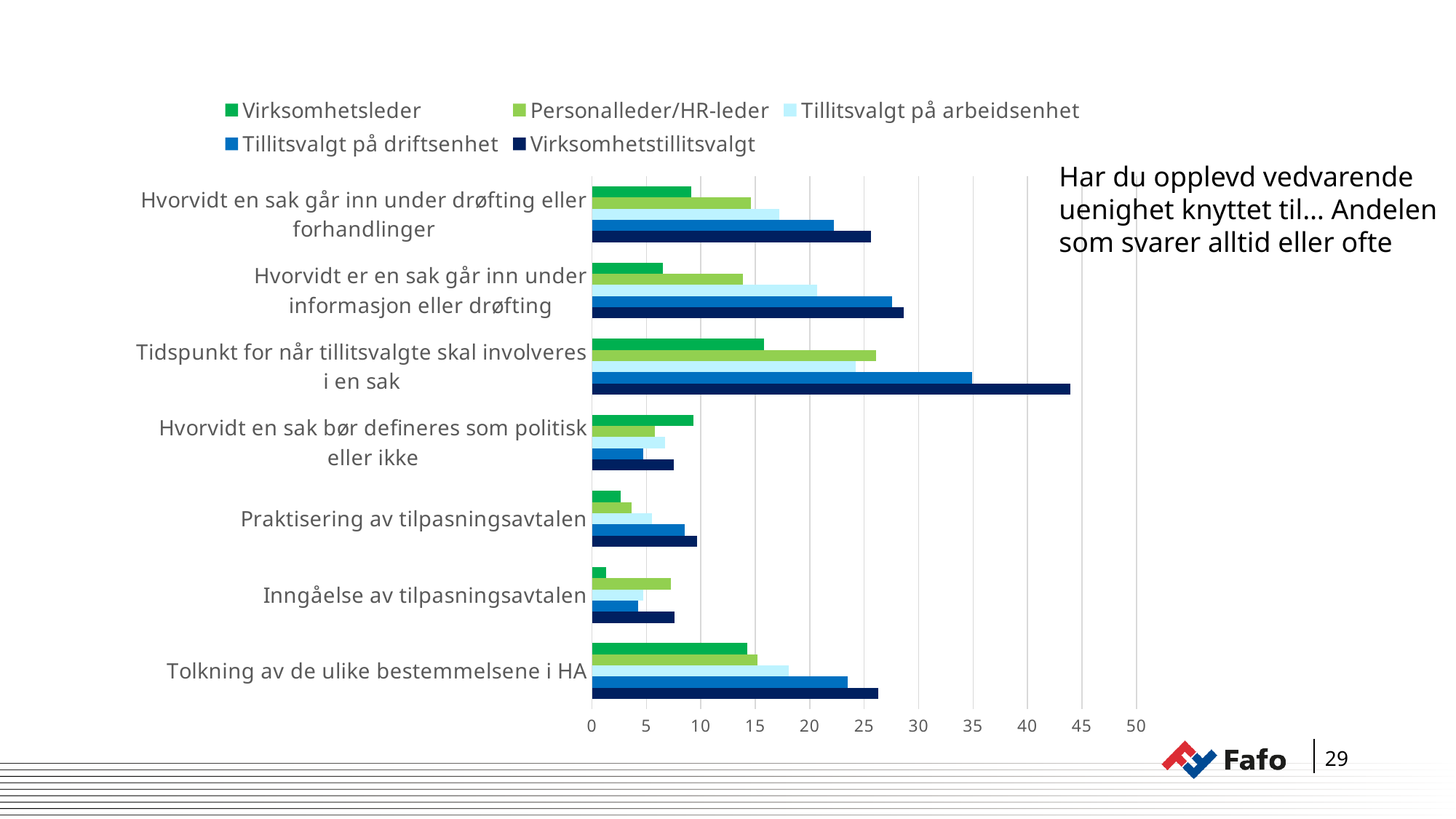
What kind of chart is shown on the slide? bar chart What is the highest tick value shown on the horizontal axis? 50 For 'Tidspunkt for når tillitsvalgte skal involveres i en sak', which is larger: Virksomhetsleder or Virksomhetstillitsvalgt? Virksomhetstillitsvalgt Is the Virksomhetstillitsvalgt value for 'Tidspunkt for når tillitsvalgte skal involveres i en sak' greater or less than 40? greater Which category has the lowest value for Virksomhetsleder? Inngåelse av tilpasningsavtalen What is the title text shown to the right of the chart? Har du opplevd vedvarende uenighet knyttet til… Andelen som svarer alltid eller ofte For 'Hvorvidt en sak bør defineres som politisk eller ikke', which is larger: Virksomhetsleder or Tillitsvalgt på driftsenhet? Virksomhetsleder How many series does the legend list? 5 Is the Tillitsvalgt på driftsenhet value for 'Tidspunkt for når tillitsvalgte skal involveres i en sak' greater or less than 30? greater How many categories are shown on the vertical axis of the chart? 7 Is the Virksomhetsleder value for 'Inngåelse av tilpasningsavtalen' greater or less than 5? less Which category has the highest value for Virksomhetstillitsvalgt? Tidspunkt for når tillitsvalgte skal involveres i en sak